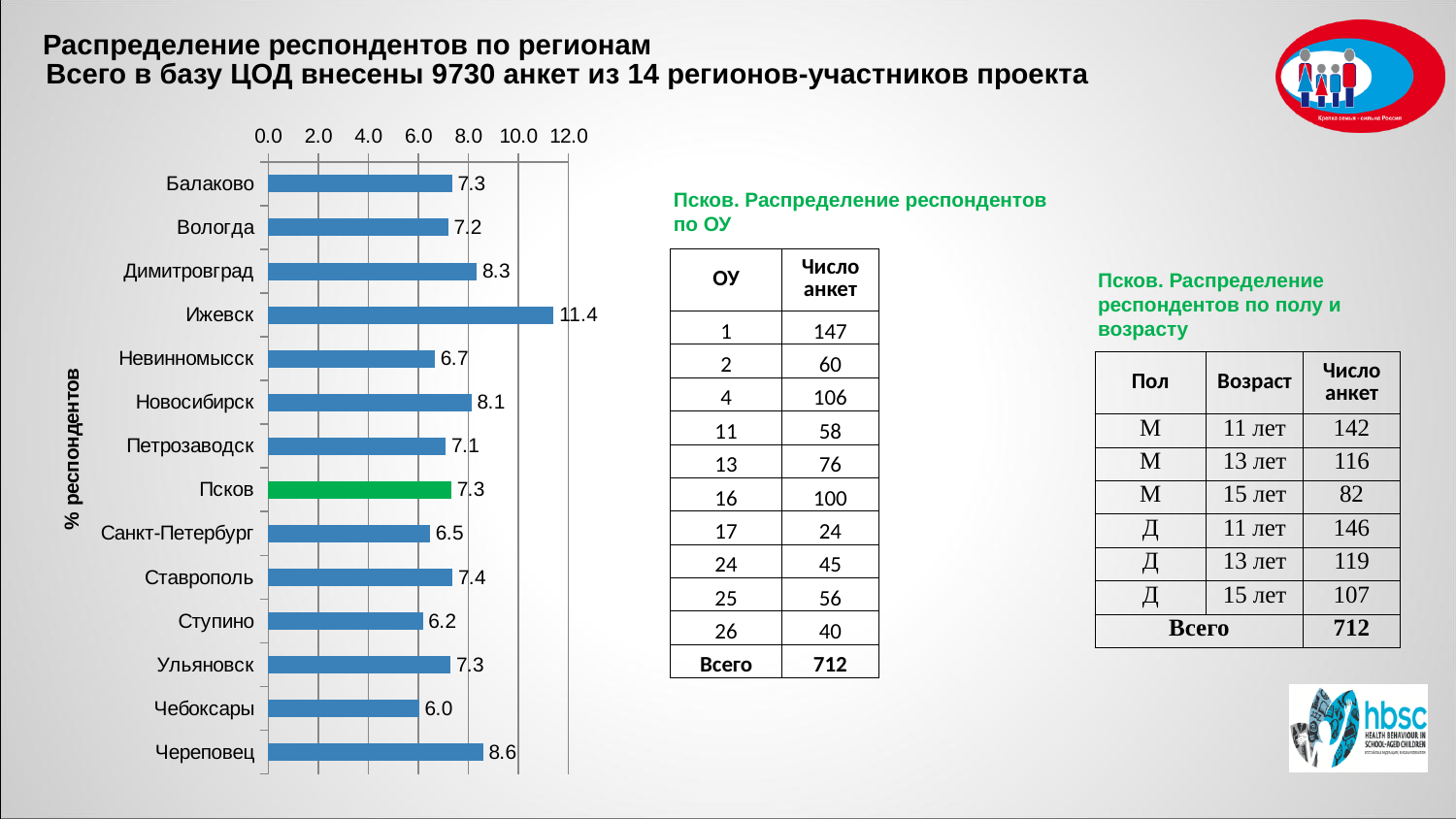
How many regions are shown in the bar chart? 14 Is the value for Череповец in the bar chart greater or less than 8.0? greater What is the value for Ижевск in the bar chart? 11.4 Which has a larger value in the bar chart, Новосибирск or Невинномысск? Новосибирск What is the difference between the values for Ижевск and Чебоксары in the bar chart? 5.4 What is the value for Санкт-Петербург in the bar chart? 6.5 What kind of chart is shown on the slide? bar chart What is the difference between the values for Димитровград and Ступино in the bar chart? 2.1 What is the value for Череповец in the bar chart? 8.6 Which region has the lowest value in the bar chart? Чебоксары Which region's bar is coloured green in the bar chart? Псков Which region has the highest value in the bar chart? Ижевск